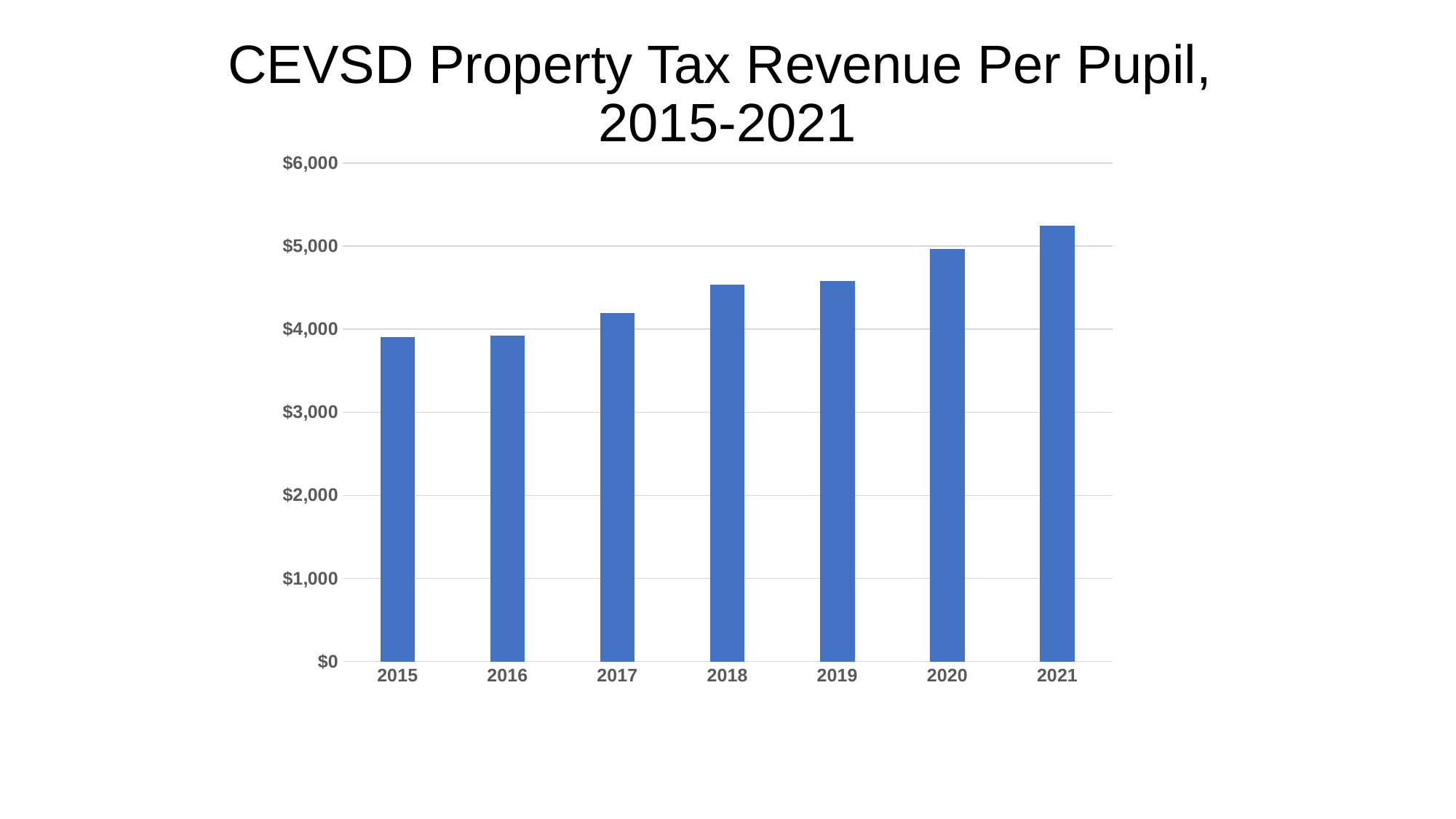
What kind of chart is shown on the slide? bar chart What is the title of the chart? CEVSD Property Tax Revenue Per Pupil, 2015-2021 Is the value for 2021 greater or less than $5,000? greater How many years are shown on the x axis? 7 Is the value for 2019 greater or less than $5,000? less Is the value for 2015 greater or less than $4,000? less What colour are the bars in the chart? blue Which is larger, the value for 2020 or the value for 2016? 2020 Which year has the highest property tax revenue per pupil? 2021 Do the values generally rise or fall from 2015 to 2021? rise